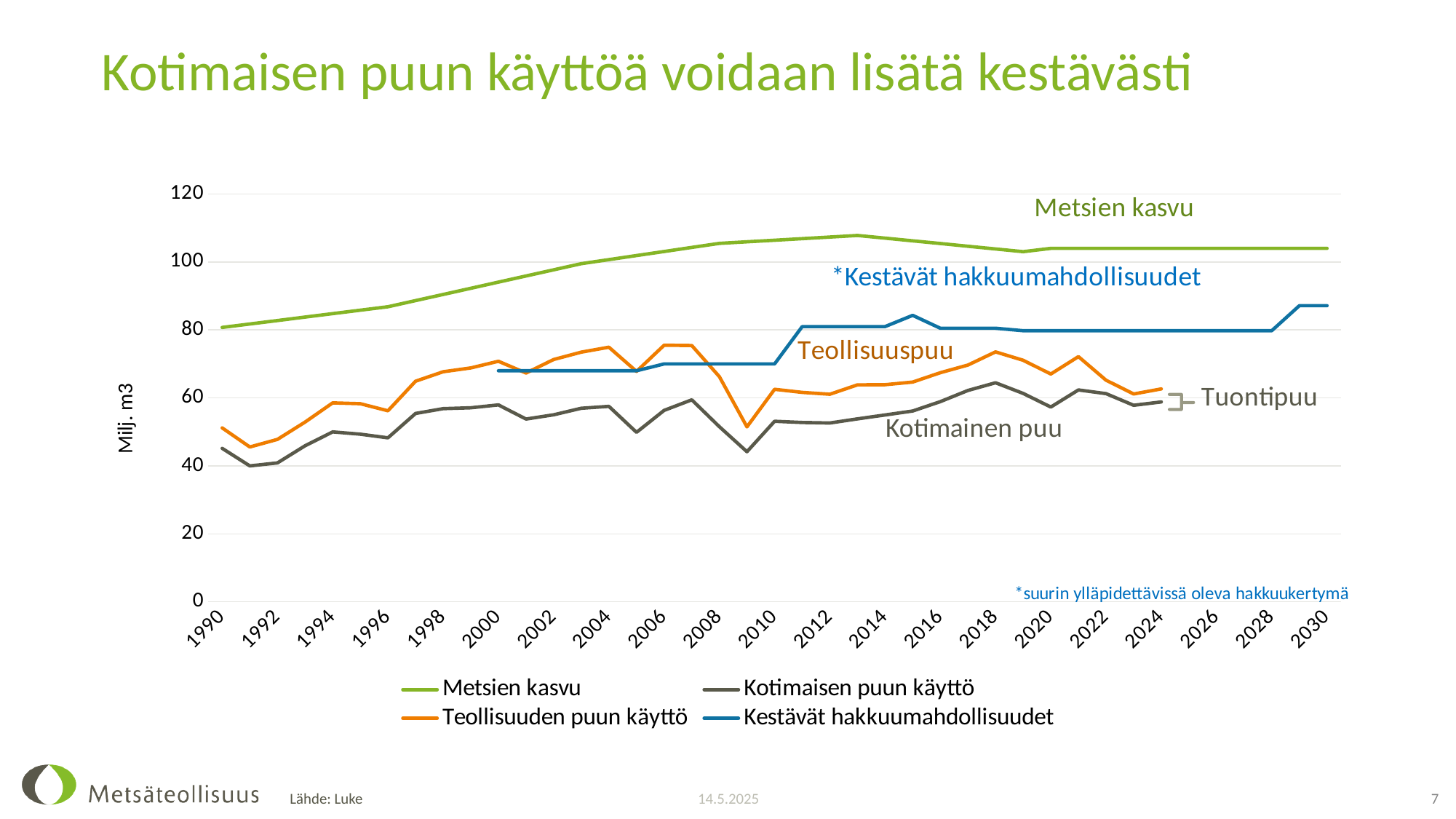
What kind of chart is shown on the slide? line chart Is the value of Kestävät hakkuumahdollisuudet in 2030 greater or less than 80? greater Is the value of Teollisuuden puun käyttö in 2010 greater or less than 60? greater Is the value of Metsien kasvu in 2018 greater or less than 100? greater How many series does the legend list? 4 What is the label of the y axis? Milj. m3 Which series has the highest values across the whole chart? Metsien kasvu In 2020, which is larger: Kestävät hakkuumahdollisuudet or Teollisuuden puun käyttö? Kestävät hakkuumahdollisuudet Does Metsien kasvu rise or fall from 1990 to 2018? rise How many year labels are shown on the x axis? 21